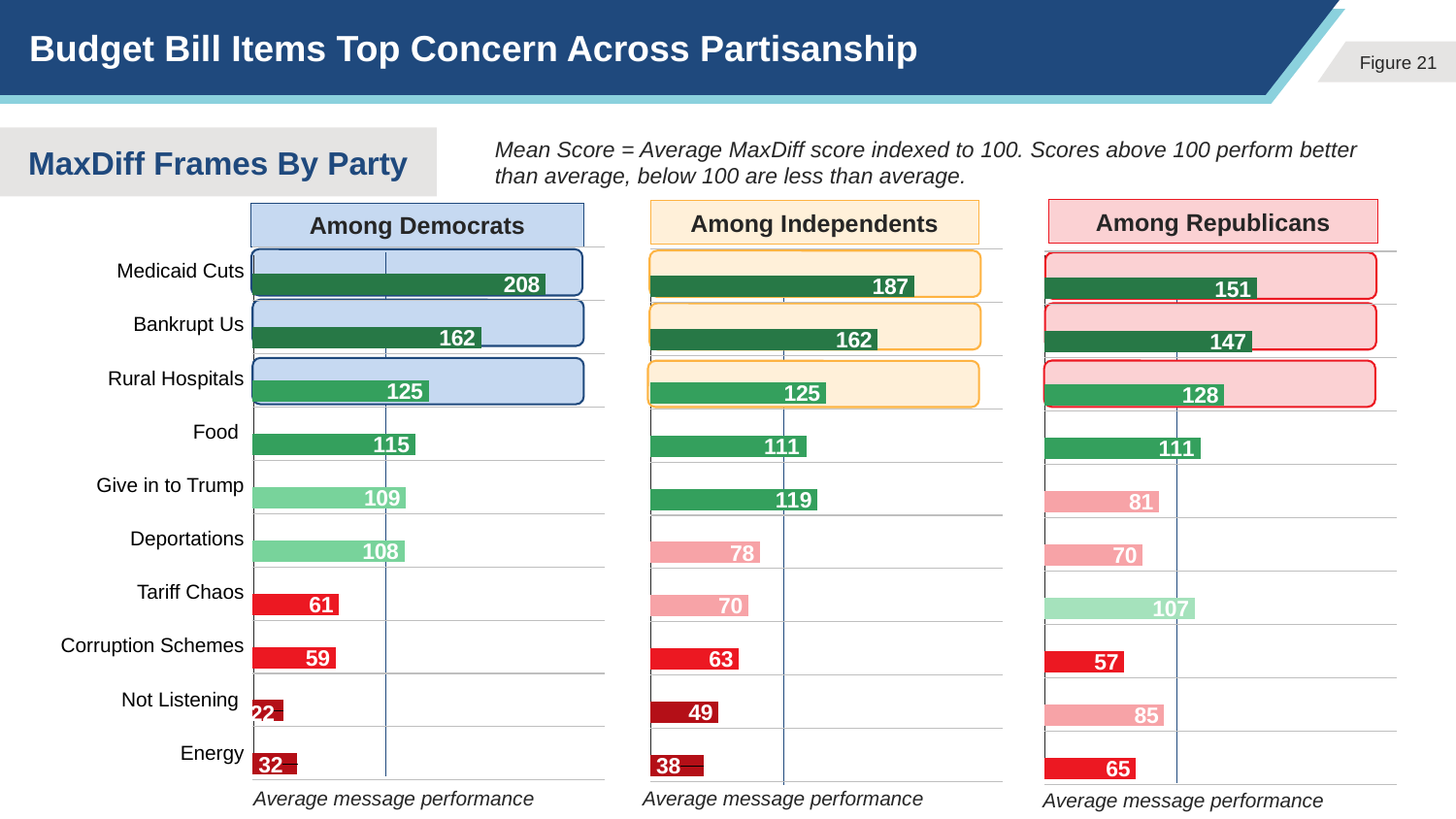
In the Among Democrats chart, what is the difference between the values for Medicaid Cuts and Bankrupt Us? 46 In the Among Republicans chart, which category has the highest value? Medicaid Cuts In the Among Democrats chart, which category has the lowest value? Not Listening In the Among Republicans chart, what is the value for Tariff Chaos? 107 In the Among Independents chart, what is the value for Give in to Trump? 119 In the Among Republicans chart, what is the difference between the values for Not Listening and Corruption Schemes? 28 What kind of chart is the Among Republicans chart? Bar chart In the Among Independents chart, which category has the lowest value? Energy How many categories are shown in the Among Democrats chart? 10 In the Among Democrats chart, what is the value for Medicaid Cuts? 208 What is the title of the chart on the left of the slide? Among Democrats In the Among Independents chart, which is larger: the value for Deportations or the value for Tariff Chaos? Deportations